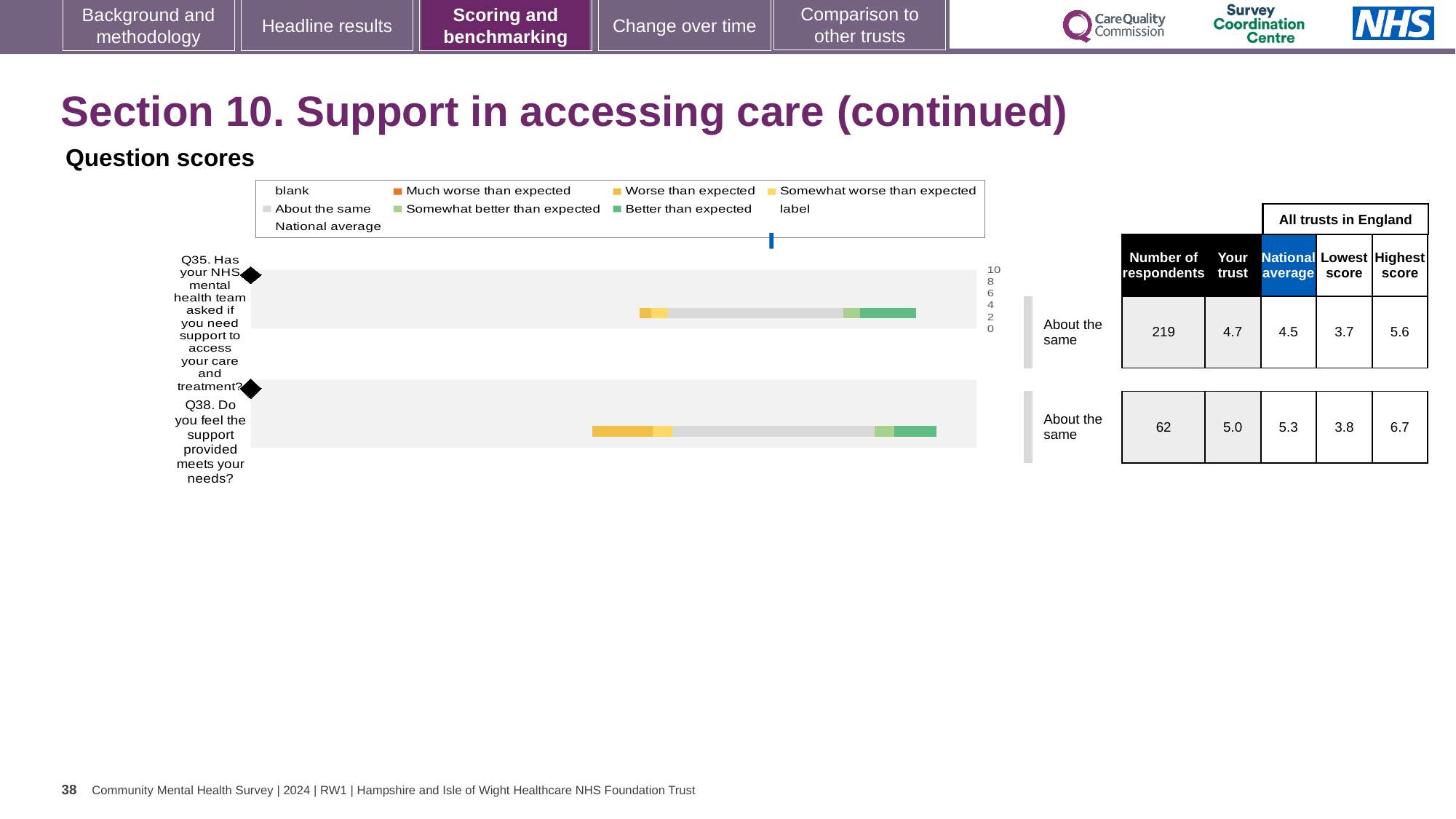
What benchmark category is given for Q35 next to the chart? About the same According to the table beside the chart, what is the 'Your trust' score for Q35? 4.7 How many respondents answered Q38? 62 Which question has the higher 'Your trust' score, Q35 or Q38? Q38 By how much does the trust's score for Q35 exceed the national average? 0.2 How many survey questions are plotted in the chart? 2 According to the table beside the chart, what is the 'Your trust' score for Q38? 5.0 What is the lowest score among all trusts in England for Q35? 3.7 What kind of chart is shown under 'Question scores'? bar chart What is the national average score for Q35 shown in the table? 4.5 What is the difference between the highest and lowest scores for Q38? 2.9 What is the highest score among all trusts in England for Q38? 6.7